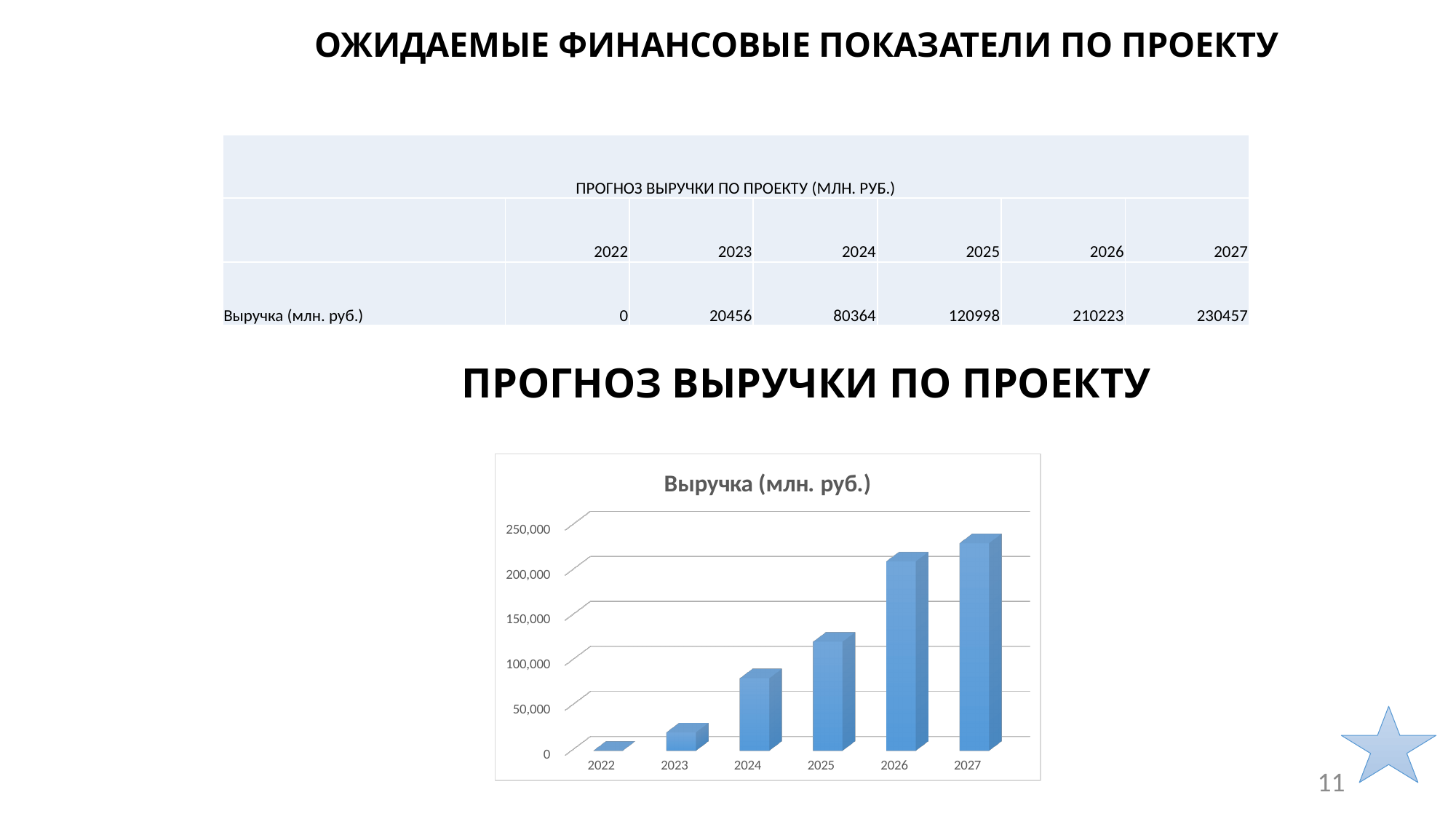
Is the revenue for 2025 greater or less than 100,000? greater Do the revenue values rise or fall from 2022 to 2027? rise What kind of chart is shown on the slide? bar chart Is the revenue for 2026 greater or less than 200,000? greater Which year has the highest revenue in the chart? 2027 How many years are shown on the x axis of the chart? 6 According to the table on the slide, what is the revenue (млн. руб.) for 2027? 230457 According to the table on the slide, what is the difference in revenue between 2027 and 2026? 20234 What is the title of the chart? Выручка (млн. руб.) Which year has the lowest revenue in the chart? 2022 Is the revenue for 2024 greater or less than 100,000? less Which year has the larger revenue, 2023 or 2024? 2024